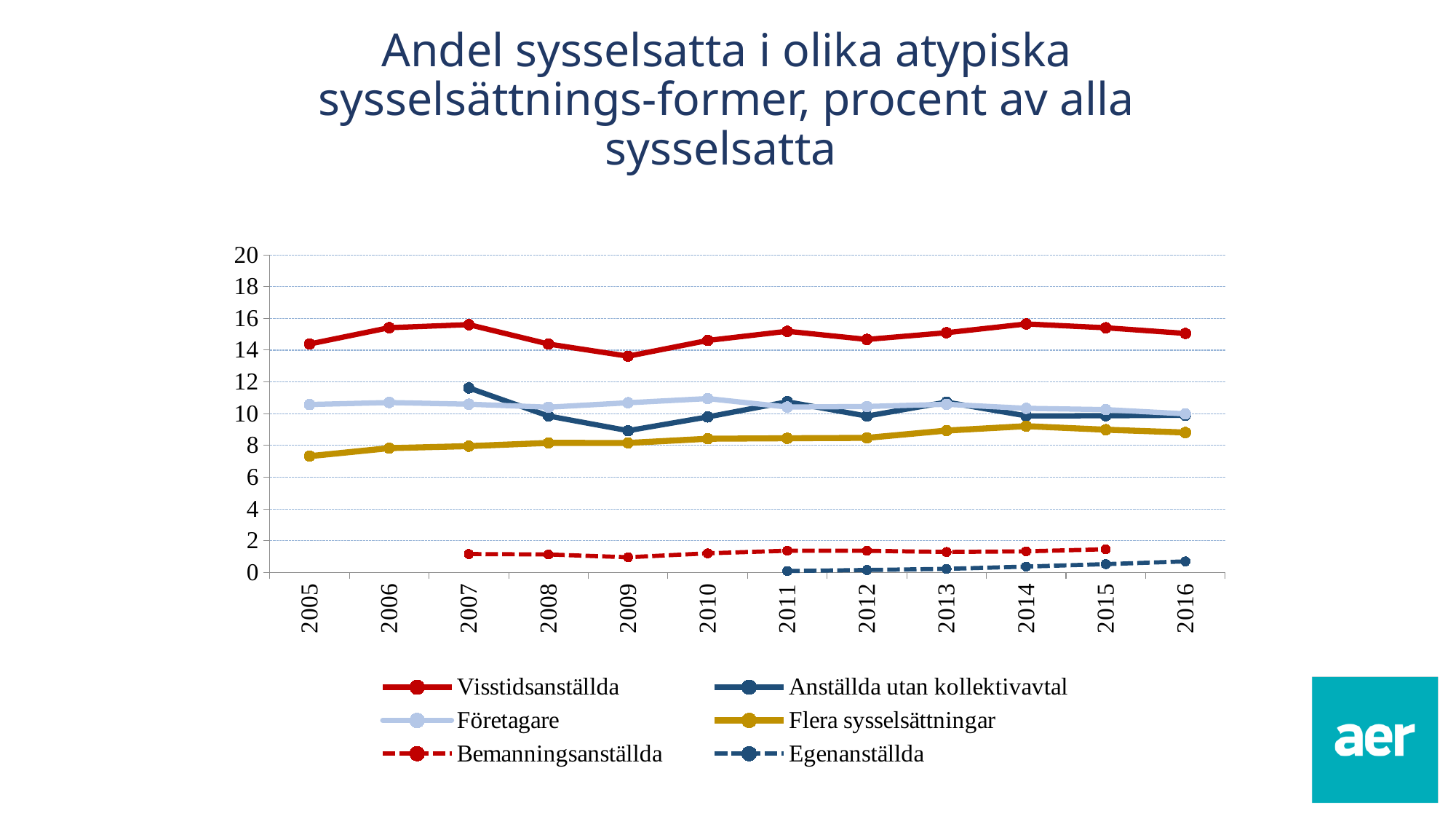
Is the value for Anställda utan kollektivavtal in 2007 greater or less than 10? greater Is the value for Visstidsanställda in 2009 greater or less than 14? less In which year is the value for Visstidsanställda lowest? 2009 In which year does the Egenanställda series first appear on the chart? 2011 Which series has the highest values across all years? Visstidsanställda How many years are shown on the x axis? 12 How many series does the legend list? 6 Is the value for Bemanningsanställda in 2015 greater or less than 2? less In which year is the value for Flera sysselsättningar lowest? 2005 Which is larger in 2016, Anställda utan kollektivavtal or Flera sysselsättningar? Anställda utan kollektivavtal What kind of chart is shown on the slide? Line chart Does the value for Anställda utan kollektivavtal rise or fall from 2007 to 2016? Fall